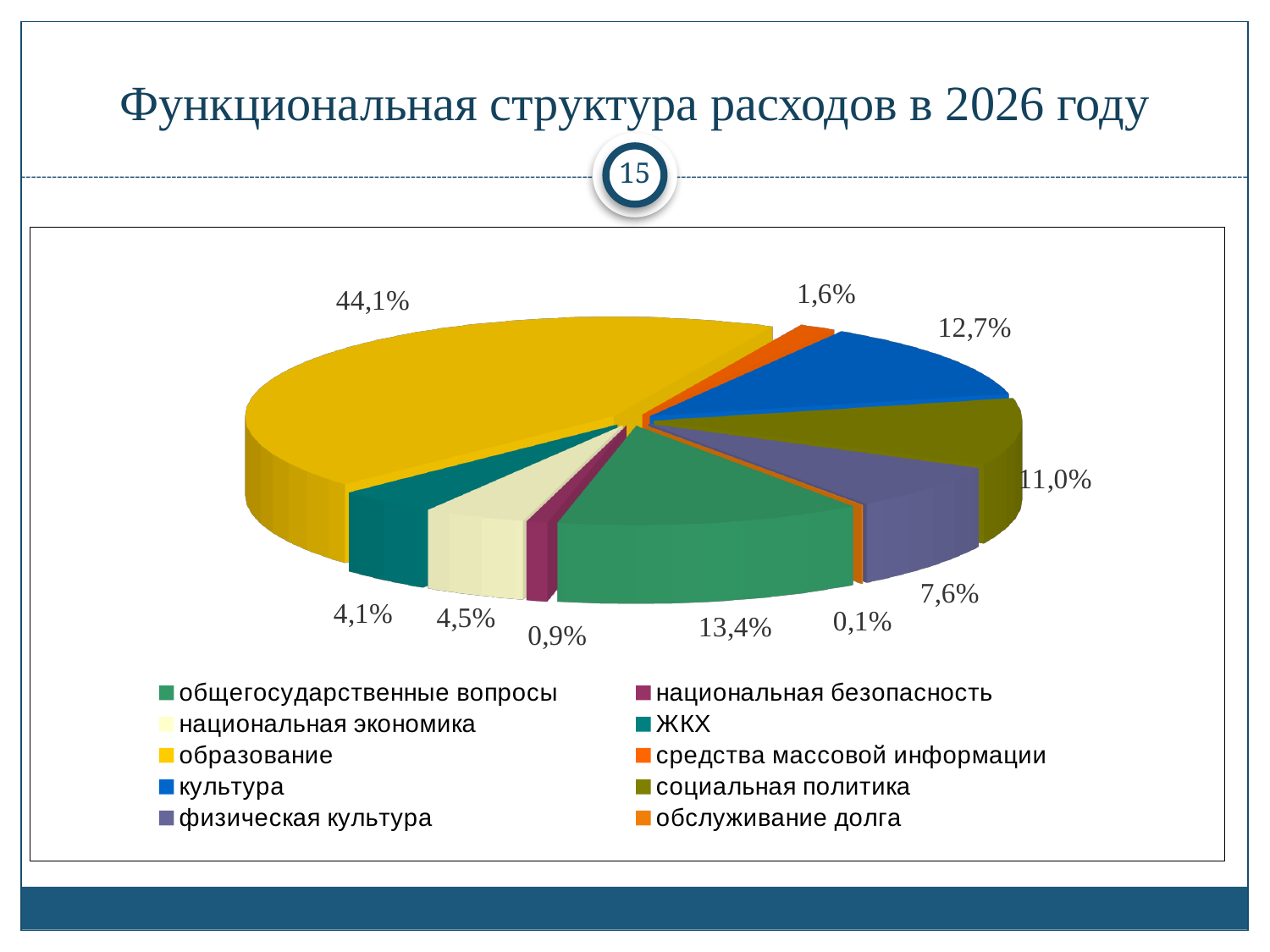
How many categories does the legend list? 10 Which category has the smallest share of expenditures? обслуживание долга What share of expenditures goes to образование? 44,1% What is the value for социальная политика? 11,0% What is the value for общегосударственные вопросы? 13,4% Which category has the largest share of expenditures? образование What is the difference between the shares for культура and социальная политика? 1,7% Which is larger, the share for национальная экономика or the share for ЖКХ? национальная экономика What is the value for обслуживание долга? 0,1% What kind of chart is shown on the slide? Pie chart What is the value for культура? 12,7% What is the title of the slide? Функциональная структура расходов в 2026 году